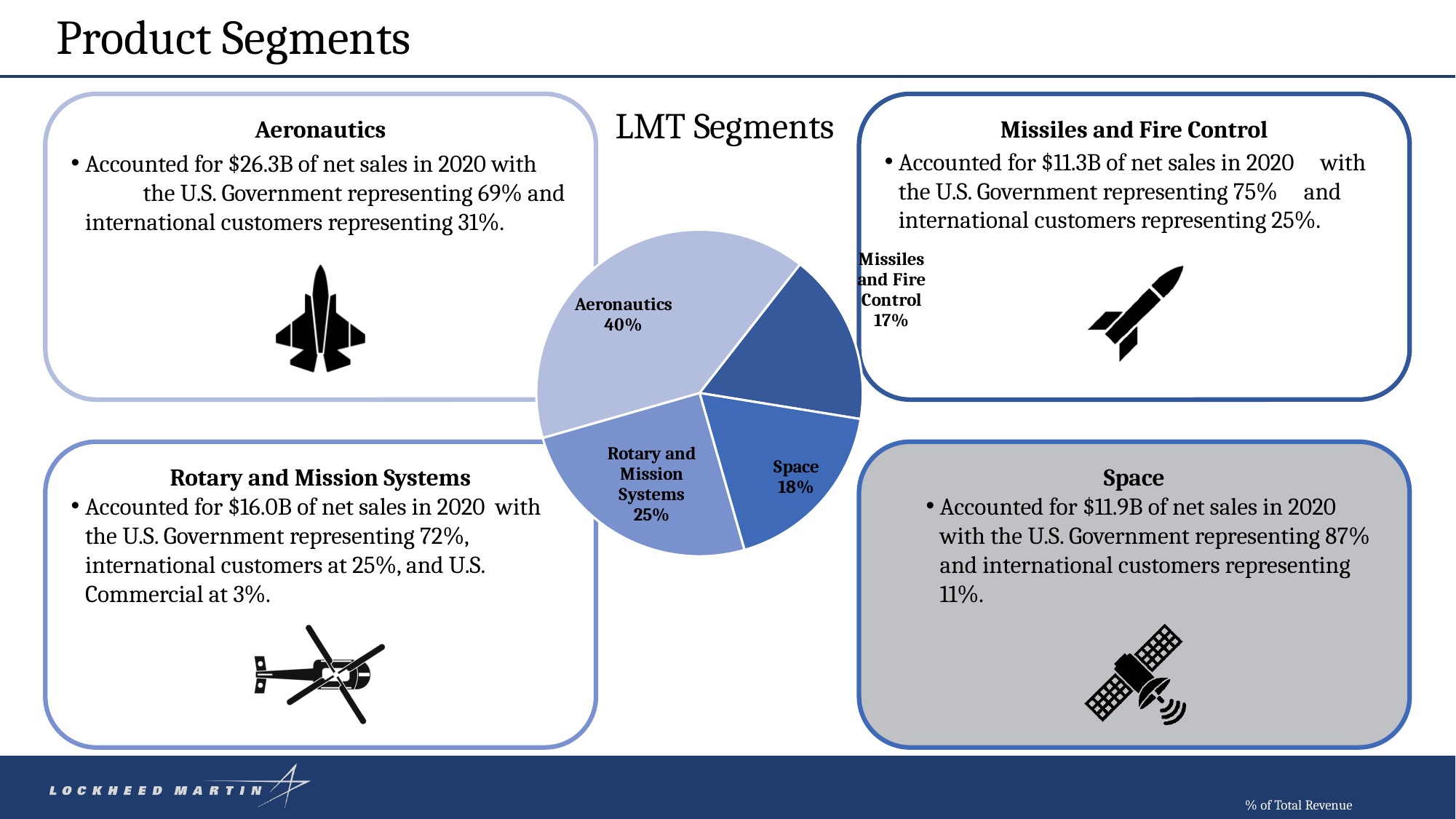
What is the value shown for Space? 18% Which segment has the smallest slice of the pie? Missiles and Fire Control What is the difference between the Rotary and Mission Systems share and the Space share? 7% What share of the pie does Aeronautics represent? 40% What kind of chart is shown on the slide? pie chart What is the difference between the Aeronautics share and the Rotary and Mission Systems share? 15% Which is larger, the Space slice or the Missiles and Fire Control slice? Space How many segments are shown in the pie chart? 4 What is the value shown for Missiles and Fire Control? 17% What is the title of the chart? LMT Segments What is the value shown for Rotary and Mission Systems? 25% Which segment has the largest slice of the pie? Aeronautics